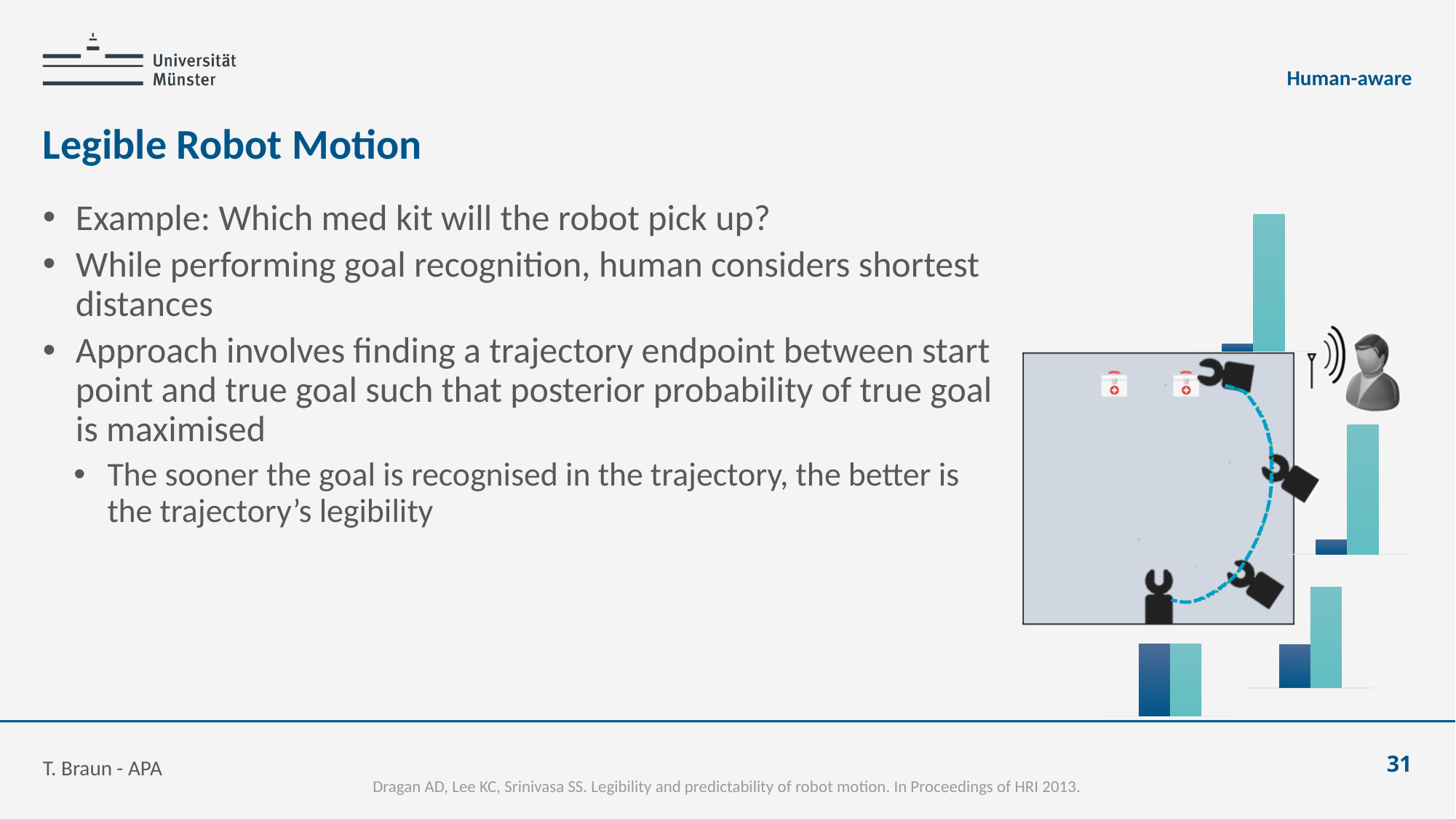
Do the small bar charts on the slide show any axis labels or data value labels? No How many bars does each small bar chart on the slide contain? 2 In the bar chart at the bottom right of the slide (below the grey box, on the right), which bar is taller, the dark blue one or the teal one? teal How many small bar charts are shown on the slide? 4 In the bar chart at the middle right of the slide (beside the grey box), which bar is taller, the dark blue one or the teal one? teal In the bar chart at the top right of the slide (above the grey box), which bar is taller, the dark blue one or the teal one? teal What two colours are used for the bars in the small bar charts on the slide? dark blue and teal What kind of chart are the small charts on the right side of the slide? bar chart